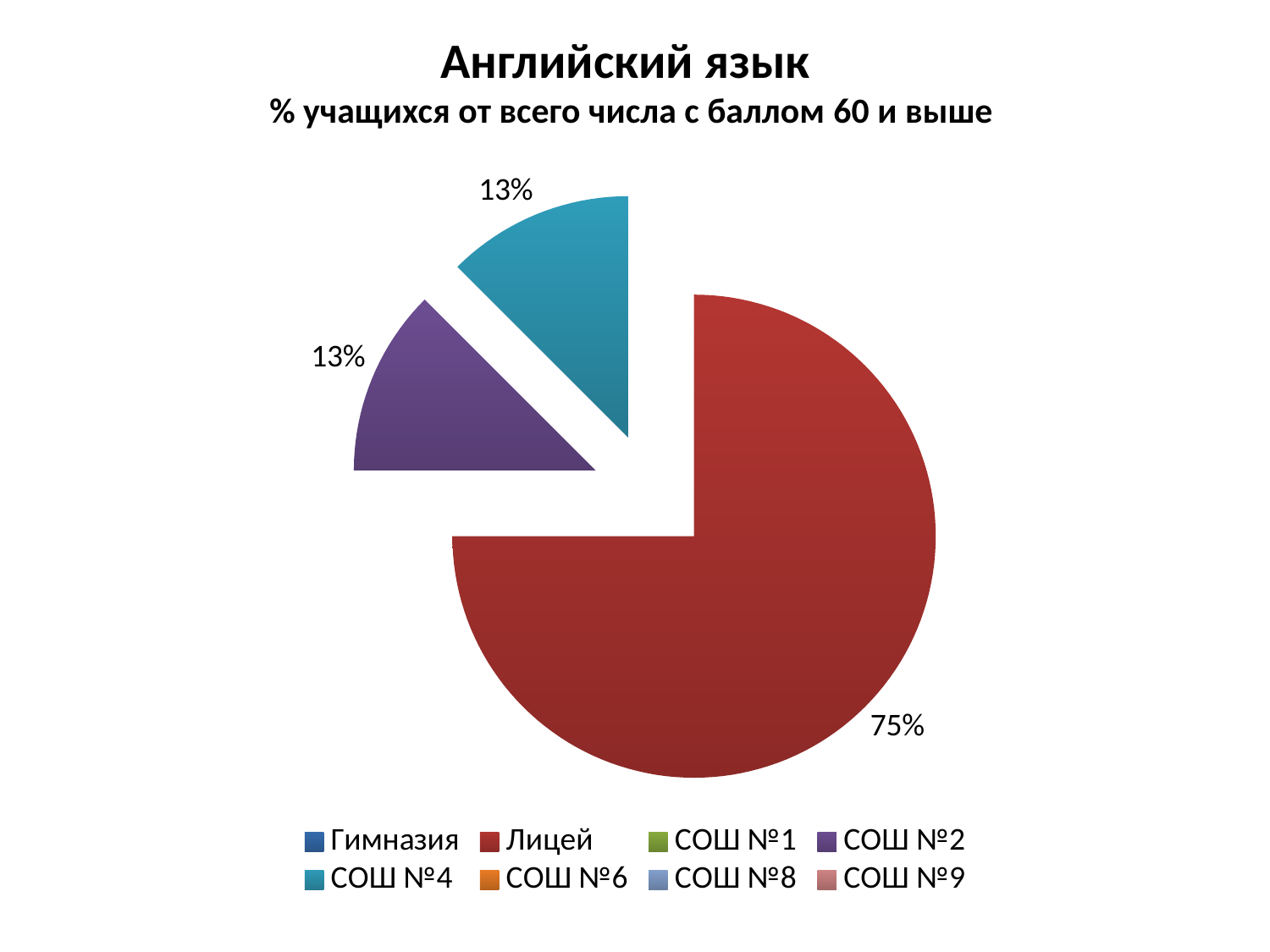
Which category has the largest slice of the pie? Лицей What percentage does the Лицей slice represent? 75% Is the value for Лицей greater or less than 50%? greater What colour is the Лицей slice? red What percentage does the СОШ №4 slice represent? 13% What percentage does the СОШ №2 slice represent? 13% What is the difference in percentage points between the Лицей slice and the СОШ №2 slice? 62 What kind of chart is shown on the slide? pie chart How many slices with data labels are visible in the pie? 3 How many categories are listed in the legend? 8 What is the title of the chart? Английский язык Which is larger, the Лицей slice or the СОШ №4 slice? Лицей